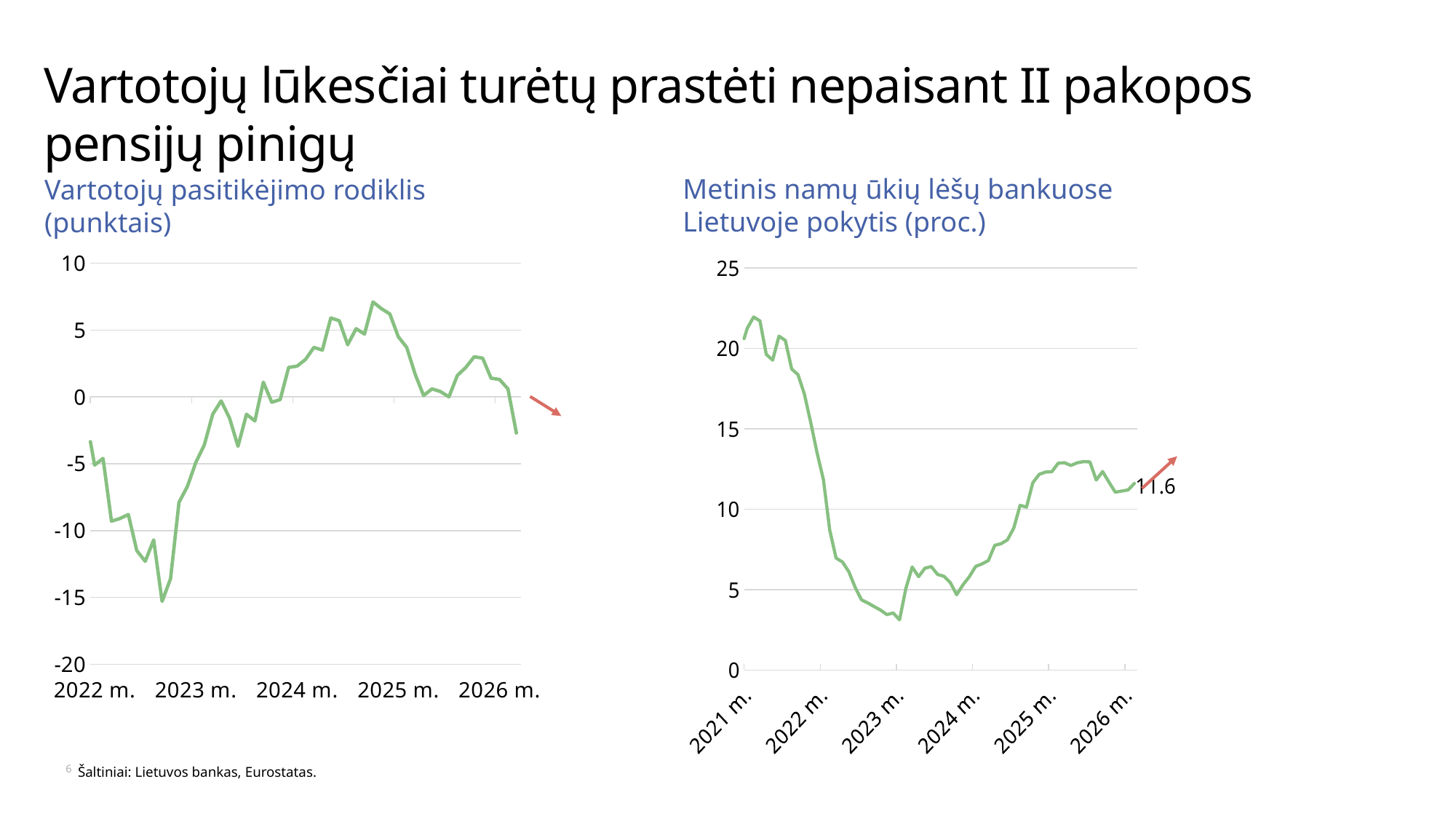
In the right chart, 'Metinis namų ūkių lėšų bankuose Lietuvoje pokytis (proc.)', is the highest value of the line (in 2021 m.) greater or less than 20? greater In the left chart, 'Vartotojų pasitikėjimo rodiklis (punktais)', does the line rise or fall between early 2023 m. and 2025 m.? rise In the left chart, 'Vartotojų pasitikėjimo rodiklis (punktais)', is the lowest value of the line (around early 2023 m.) greater or less than -10? less What kind of chart is the right chart, 'Metinis namų ūkių lėšų bankuose Lietuvoje pokytis (proc.)'? line chart In the right chart, 'Metinis namų ūkių lėšų bankuose Lietuvoje pokytis (proc.)', what is the value printed at the end of the line? 11.6 In the right chart, 'Metinis namų ūkių lėšų bankuose Lietuvoje pokytis (proc.)', does the line rise or fall between 2021 m. and 2023 m.? fall What kind of chart is the left chart, 'Vartotojų pasitikėjimo rodiklis (punktais)'? line chart What is the title of the left chart on the slide? Vartotojų pasitikėjimo rodiklis (punktais) In the left chart, 'Vartotojų pasitikėjimo rodiklis (punktais)', is the highest value of the line greater or less than 5? greater How many year labels are shown on the x axis of the right chart, 'Metinis namų ūkių lėšų bankuose Lietuvoje pokytis (proc.)'? 6